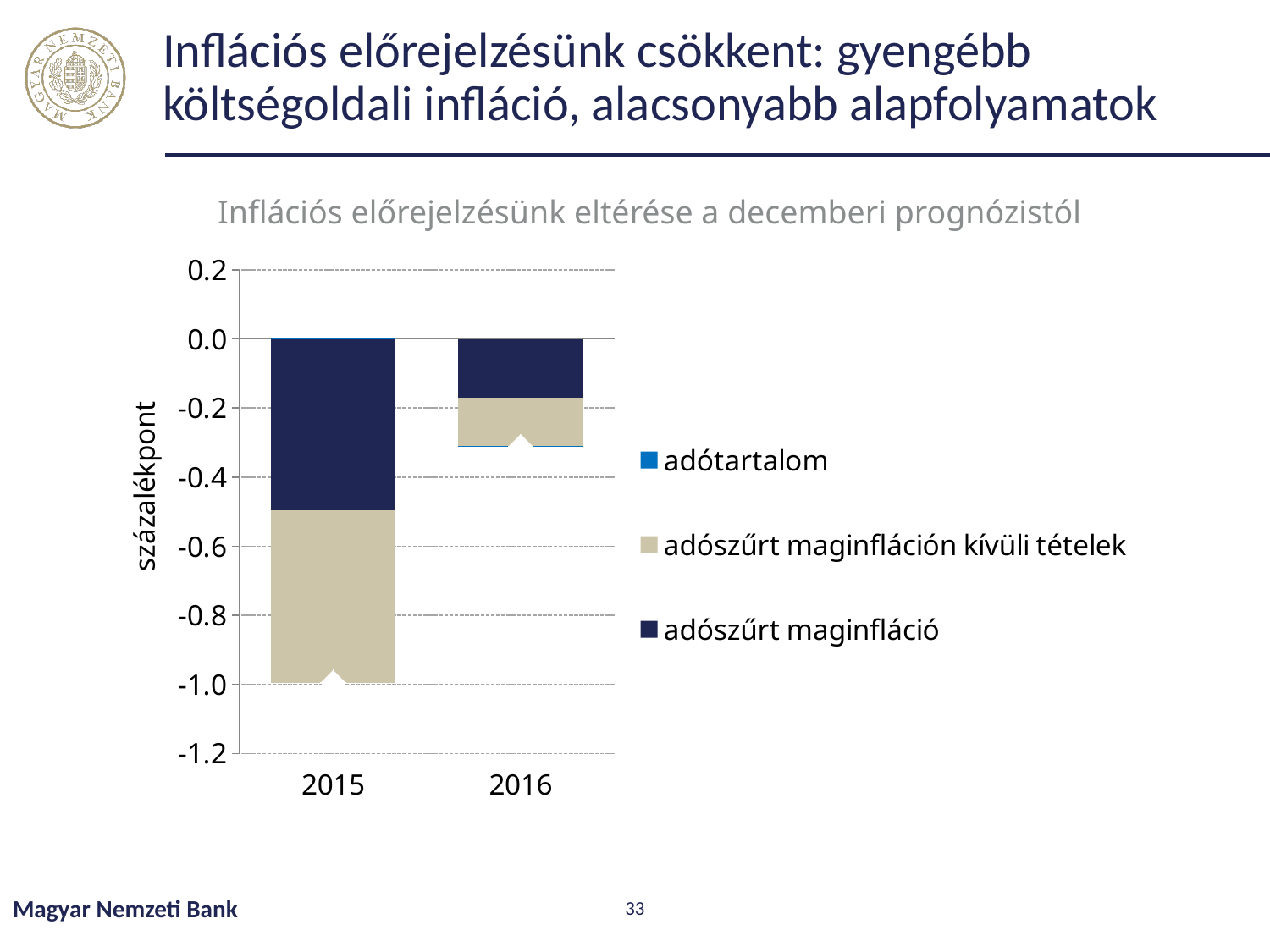
Is the total value of the 2016 bar greater or less than -0.4? greater How many series does the legend list? 3 Which year has the lowest (most negative) total bar? 2015 How many categories are shown on the x axis? 2 Is the adószűrt maginfláció value for 2016 greater or less than -0.2? greater Is the total value of the 2015 bar greater or less than -0.8? less Which year has the larger negative total deviation, 2015 or 2016? 2015 What is the label of the vertical axis? százalékpont What kind of chart is shown on the slide? stacked bar chart Do the total bar values rise or fall from 2015 to 2016? rise What is the title of the chart? Inflációs előrejelzésünk eltérése a decemberi prognózistól